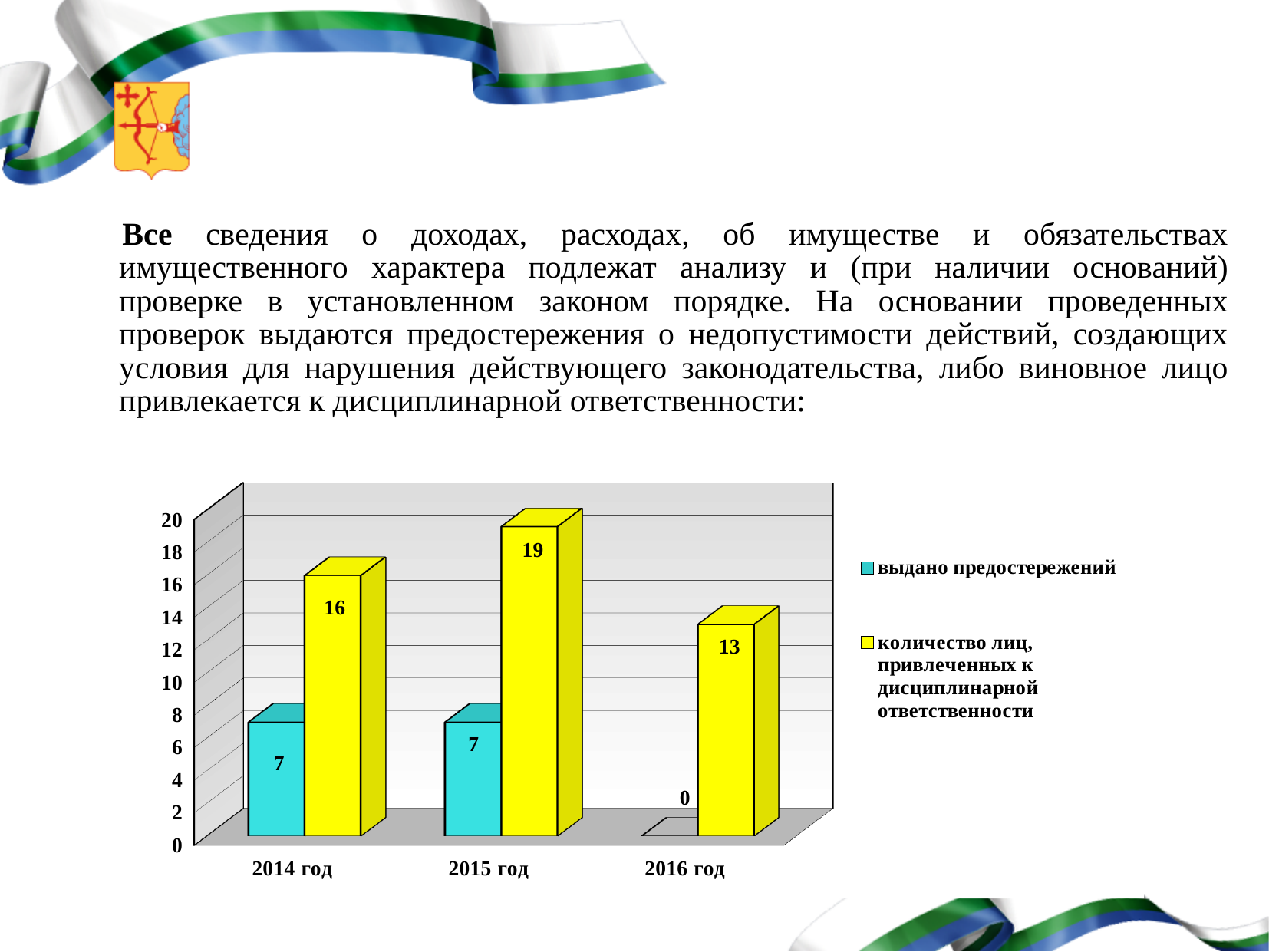
What is the value for выдано предостережений in 2016 год? 0 How many years are shown on the x axis of the chart? 3 How many warnings (выдано предостережений) were issued in 2014 год? 7 In which year was the number of persons brought to disciplinary responsibility the lowest? 2016 год What is the difference between the number of persons brought to disciplinary responsibility in 2015 год and in 2016 год? 6 What type of chart is shown on the slide? bar chart How many persons were brought to disciplinary responsibility (количество лиц, привлеченных к дисциплинарной ответственности) in 2015 год? 19 Does the number of warnings issued rise or fall from 2015 год to 2016 год? fall In which year was the number of persons brought to disciplinary responsibility the highest? 2015 год Which is larger in 2014 год: the number of warnings issued or the number of persons brought to disciplinary responsibility? количество лиц, привлеченных к дисциплинарной ответственности How many series does the legend list? 2 What colour are the bars for количество лиц, привлеченных к дисциплинарной ответственности? yellow